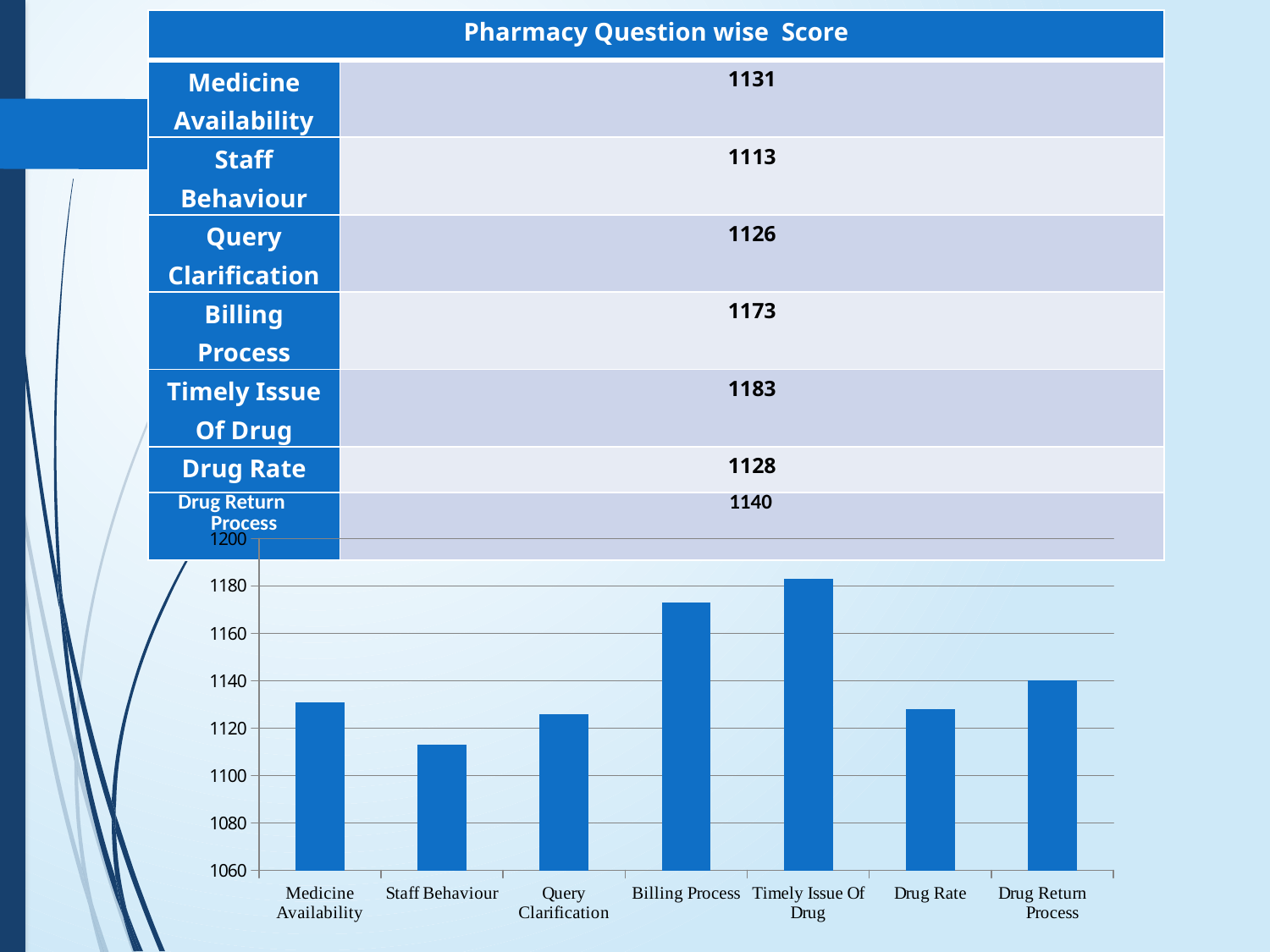
What is the score for Drug Return Process? 1140 What is the score for Timely Issue Of Drug? 1183 What is the score for Query Clarification? 1126 What is the title of the table above the chart? Pharmacy Question wise Score What is the difference between the scores for Medicine Availability and Staff Behaviour? 18 What is the difference between the scores for Timely Issue Of Drug and Billing Process? 10 Is the value for Drug Rate greater or less than 1140? less Which has a higher score, Billing Process or Drug Return Process? Billing Process What is the score for Staff Behaviour? 1113 How many categories are shown in the bar chart? 7 Which category has the highest score? Timely Issue Of Drug Which category has the lowest score? Staff Behaviour